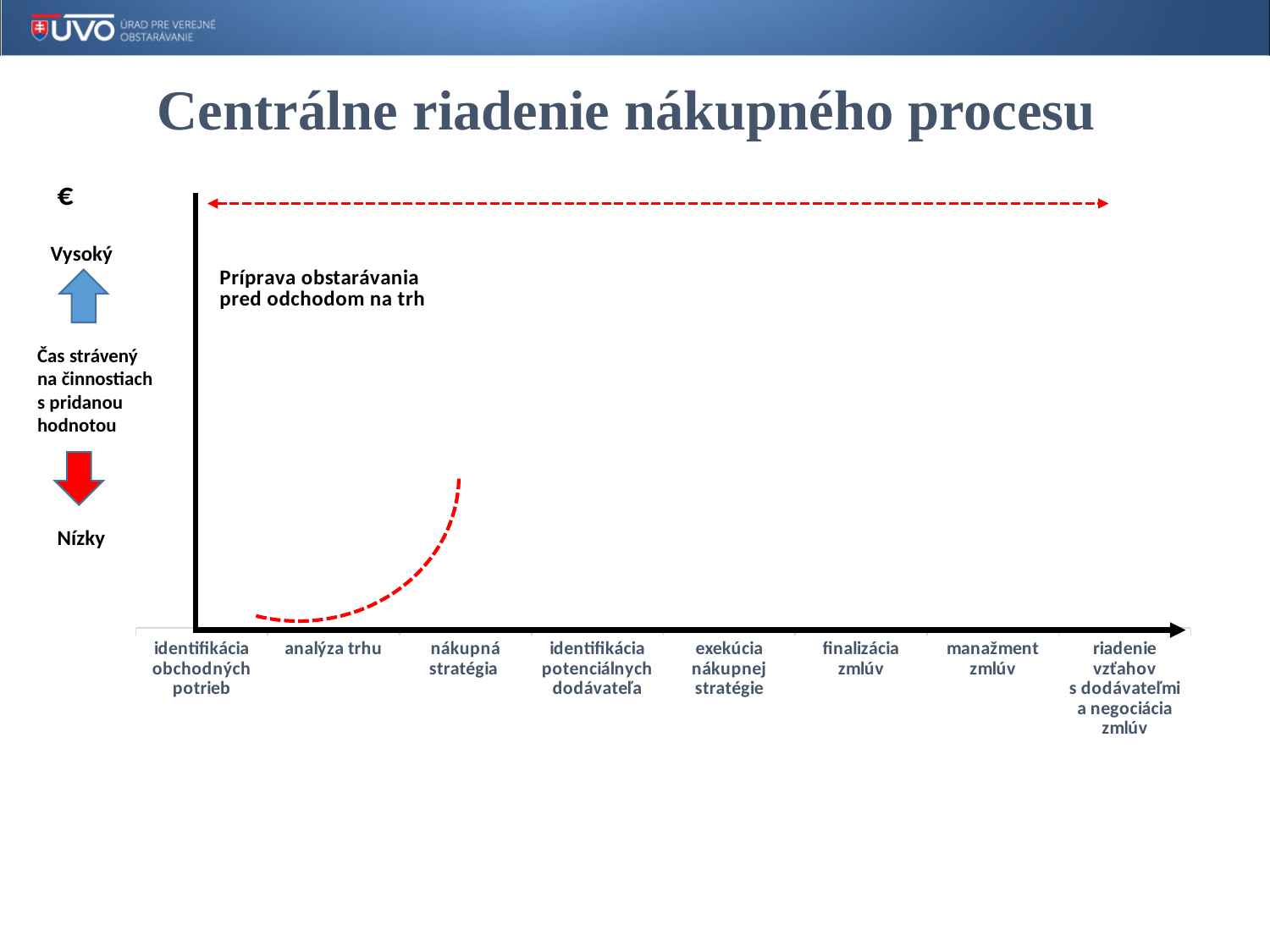
What colour is the dashed curve plotted in the chart? red What is the last stage labelled on the x axis? riadenie vzťahov s dodávateľmi a negociácia zmlúv What kind of chart is shown on the slide? line chart How many stages are labelled along the x axis of the chart? 8 What is the title of the slide containing the chart? Centrálne riadenie nákupného procesu Does the dashed red curve rise or fall as it moves from left to right along the x axis? rises